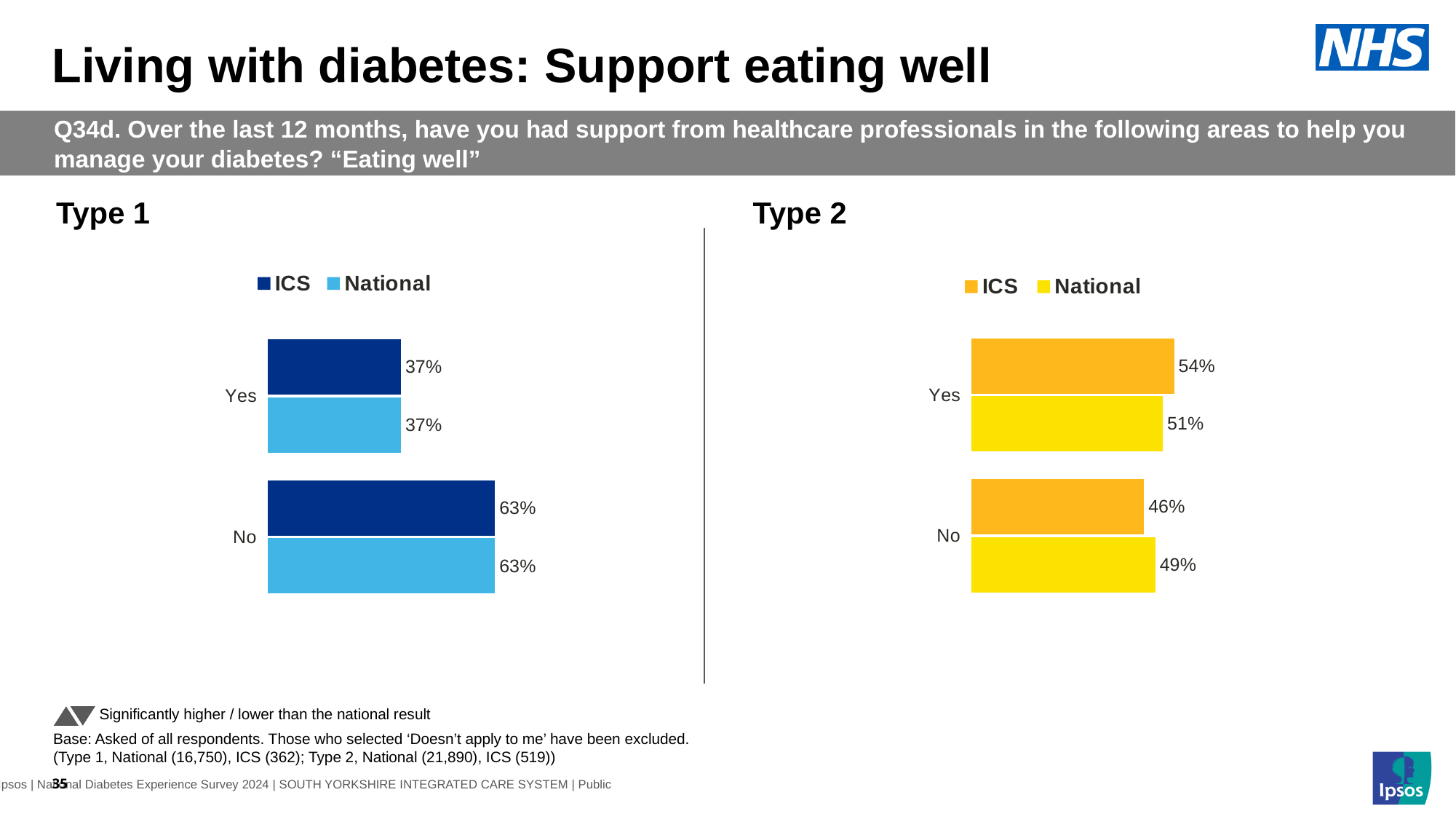
In the Type 2 chart, what is the ICS value for Yes? 54% In the Type 2 chart, what is the difference between the ICS and National values for Yes? 3% In the Type 2 chart, which category has the lowest ICS value? No What kind of chart is the Type 1 chart? Bar chart In the Type 1 chart, what is the National value for No? 63% In the Type 2 chart, what is the National value for No? 49% How many series does the legend of the Type 2 chart list? 2 In the Type 2 chart, what colour represents the National series? Yellow How many categories are shown in the Type 1 chart? 2 In the Type 2 chart, which is larger for No: ICS or National? National In the Type 1 chart, which category has the highest ICS value? No In the Type 1 chart, what is the ICS value for Yes? 37%